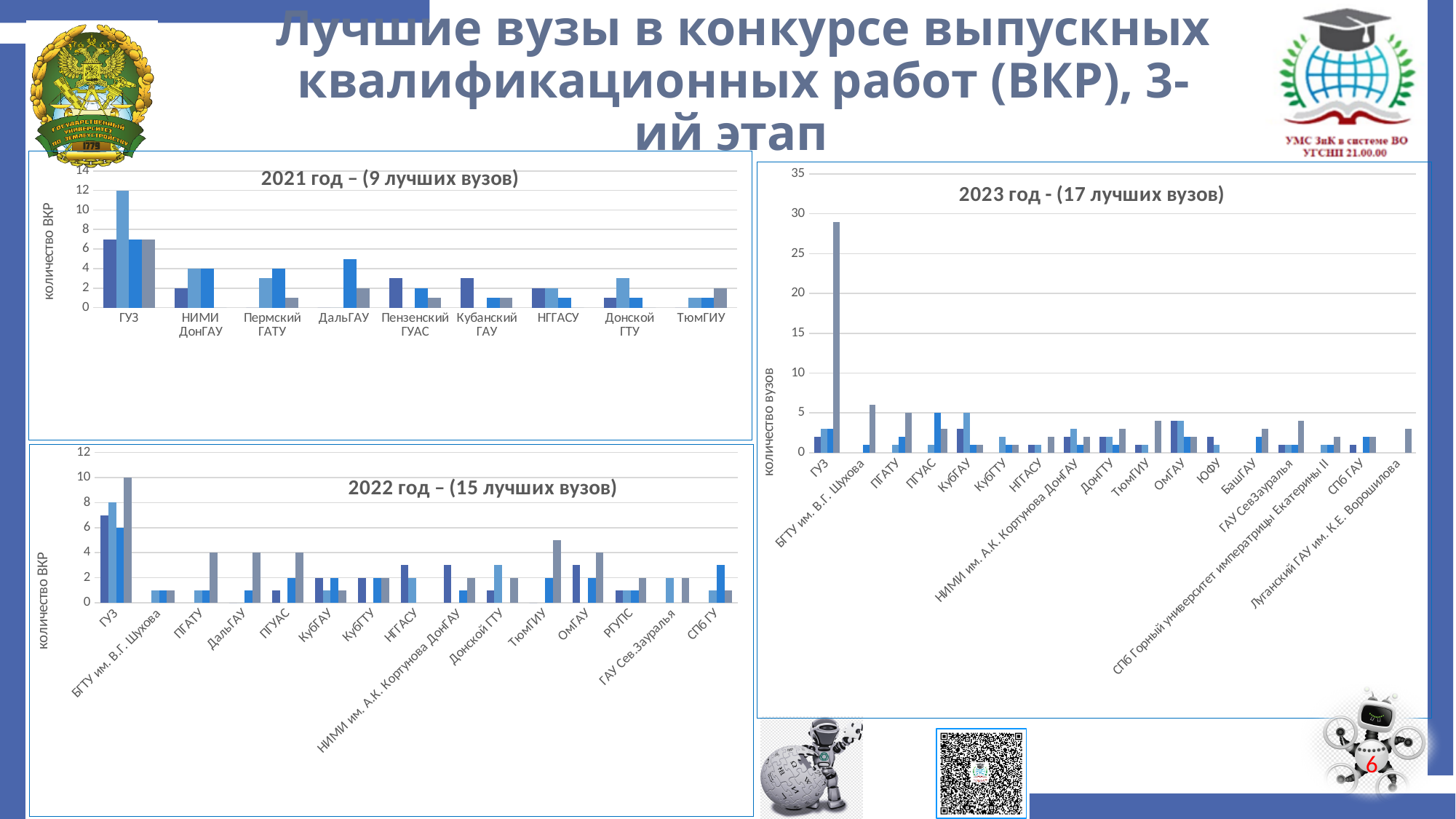
In the '2023 год - (17 лучших вузов)' chart, is the tallest bar for ПГАТУ greater or less than 10? less In the '2021 год – (9 лучших вузов)' chart, which university has the tallest bar? ГУЗ What is the title of the chart in the bottom-left of the slide? 2022 год – (15 лучших вузов) How many universities are shown on the x axis of the '2021 год – (9 лучших вузов)' chart? 9 What kind of chart is the '2021 год – (9 лучших вузов)' chart? bar chart What is the y-axis title of the '2023 год - (17 лучших вузов)' chart? количество вузов In the '2021 год – (9 лучших вузов)' chart, which has the taller tallest bar: ГУЗ or ТюмГИУ? ГУЗ In the '2023 год - (17 лучших вузов)' chart, which university has the tallest bar? ГУЗ In the '2023 год - (17 лучших вузов)' chart, is the tallest bar for ГУЗ greater or less than 25? greater In the '2022 год – (15 лучших вузов)' chart, is the tallest bar for ГУЗ greater or less than 8? greater How many universities are shown on the x axis of the '2022 год – (15 лучших вузов)' chart? 15 How many universities are shown on the x axis of the '2023 год - (17 лучших вузов)' chart? 17